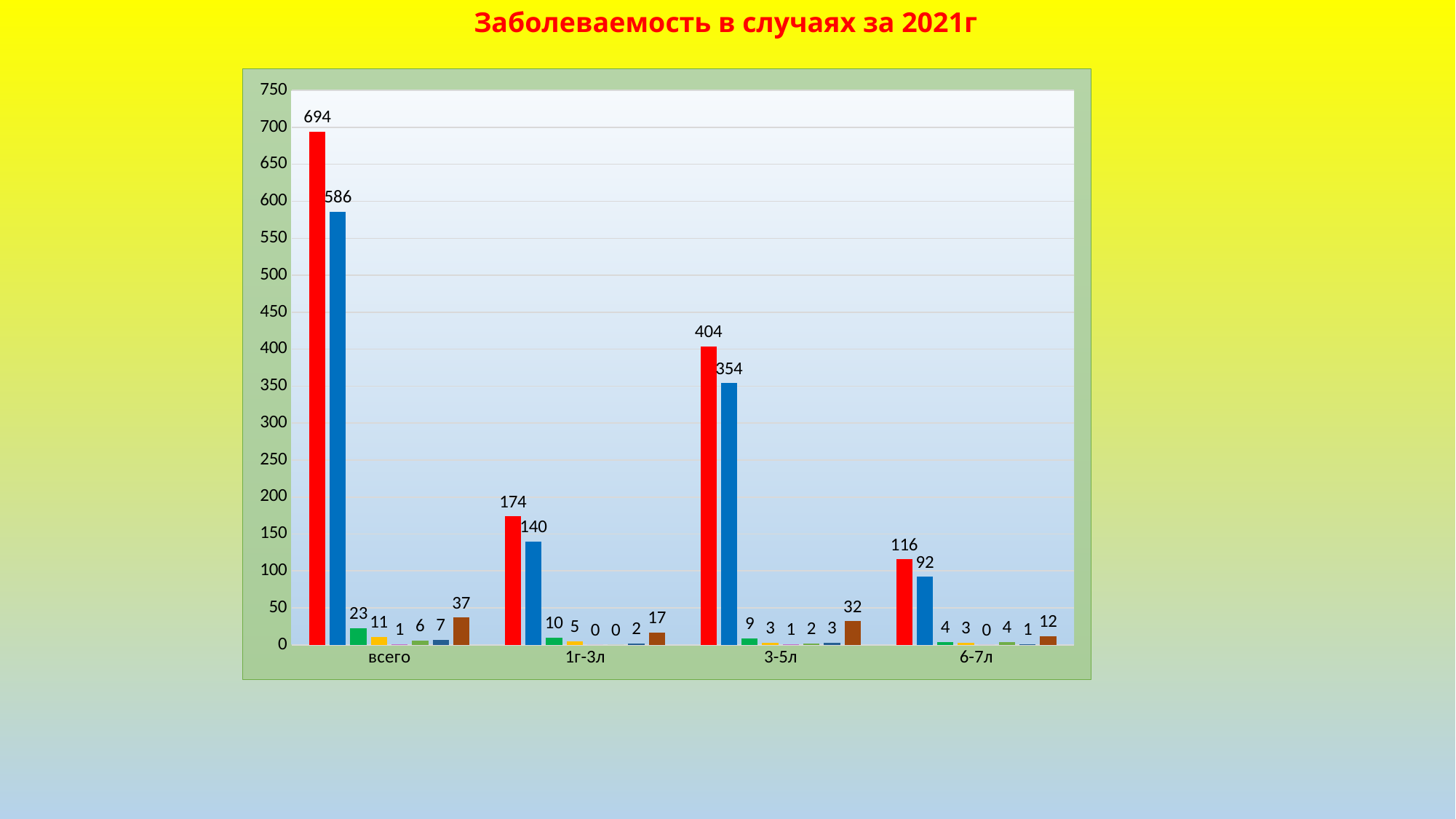
What is the title of the chart? Заболеваемость в случаях за 2021г What is the value of the red bar for the category 6-7л? 116 Which category has the lowest blue bar? 6-7л Is the value of the red bar for 1г-3л greater or less than 200? less How many categories are shown on the x axis? 4 Which is larger for the category 3-5л: the red bar or the blue bar? the red bar What is the difference between the red bar and the blue bar for the category всего? 108 What type of chart is shown on the slide? bar chart Which category has the highest red bar? всего What is the value of the brown bar for the category 1г-3л? 17 What is the value of the blue bar for the category 3-5л? 354 What is the value of the red bar for the category всего? 694